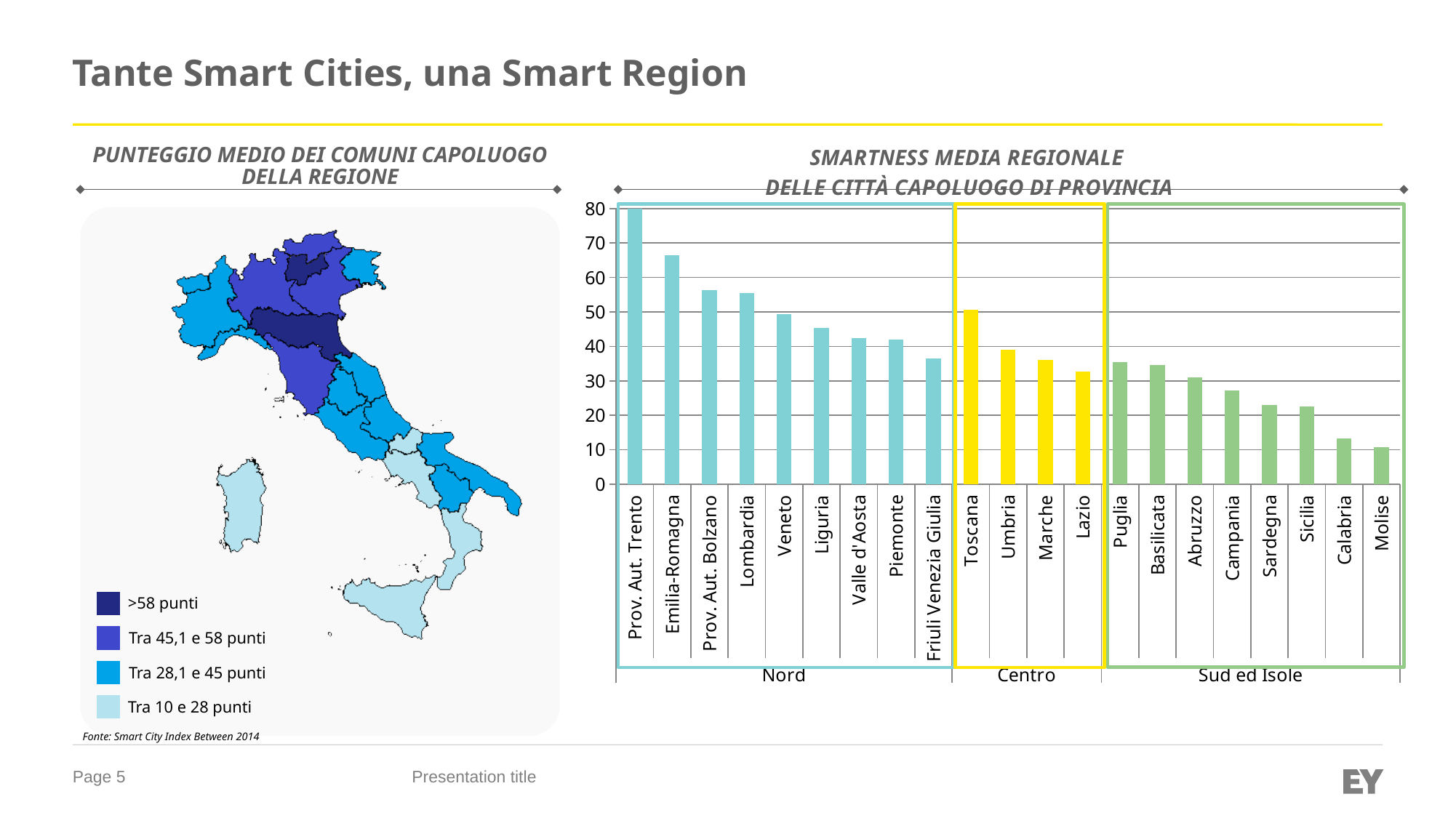
In the 'Smartness media regionale' chart, which region has the lowest value? Molise In the 'Smartness media regionale' chart, is the value for Campania greater or less than 30? less In the 'Smartness media regionale' chart, which region has the highest value? Prov. Aut. Trento In the 'Smartness media regionale' chart, is the value for Prov. Aut. Trento greater or less than 70? greater In the 'Smartness media regionale' chart, which has the larger value, Veneto or Puglia? Veneto In the 'Smartness media regionale' chart, is the value for Toscana greater or less than 40? greater What kind of chart is shown on the right side of the slide? bar chart What are the three group labels shown beneath the x axis of the 'Smartness media regionale' chart? Nord, Centro, Sud ed Isole How many regions are plotted in the 'Smartness media regionale' chart? 21 In the 'Smartness media regionale' chart, which has the larger value, Toscana or Lazio? Toscana In the 'Smartness media regionale' chart, do the values within the Nord group rise or fall from left to right? fall